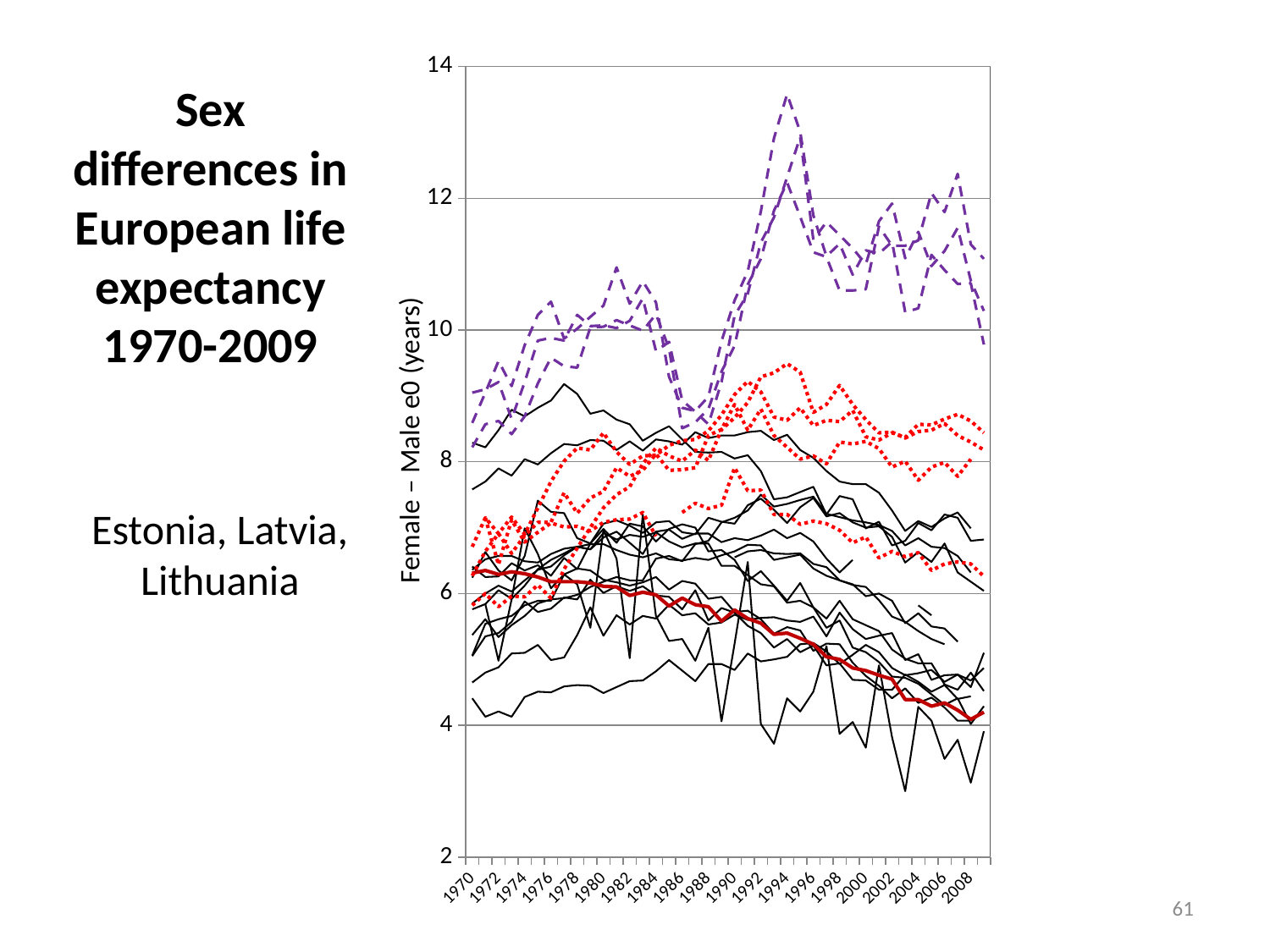
Is the peak value of the purple dashed lines around 1994 greater or less than 12? greater Is the lowest value reached by any black line around 2004 greater or less than 4? less What is the label on the vertical axis of the chart? Female – Male e0 (years) Do the purple dashed lines overall rise or fall between 1970 and 2009? rise In 1994, which is higher: the purple dashed lines or the thick red line? the purple dashed lines Does the thick red line rise or fall from 1970 to 2009? fall Is the value of the thick red line in 1970 greater or less than 5? greater What is the highest tick value shown on the vertical axis? 14 What kind of chart is shown on the slide? line chart How many year labels are shown on the horizontal axis? 20